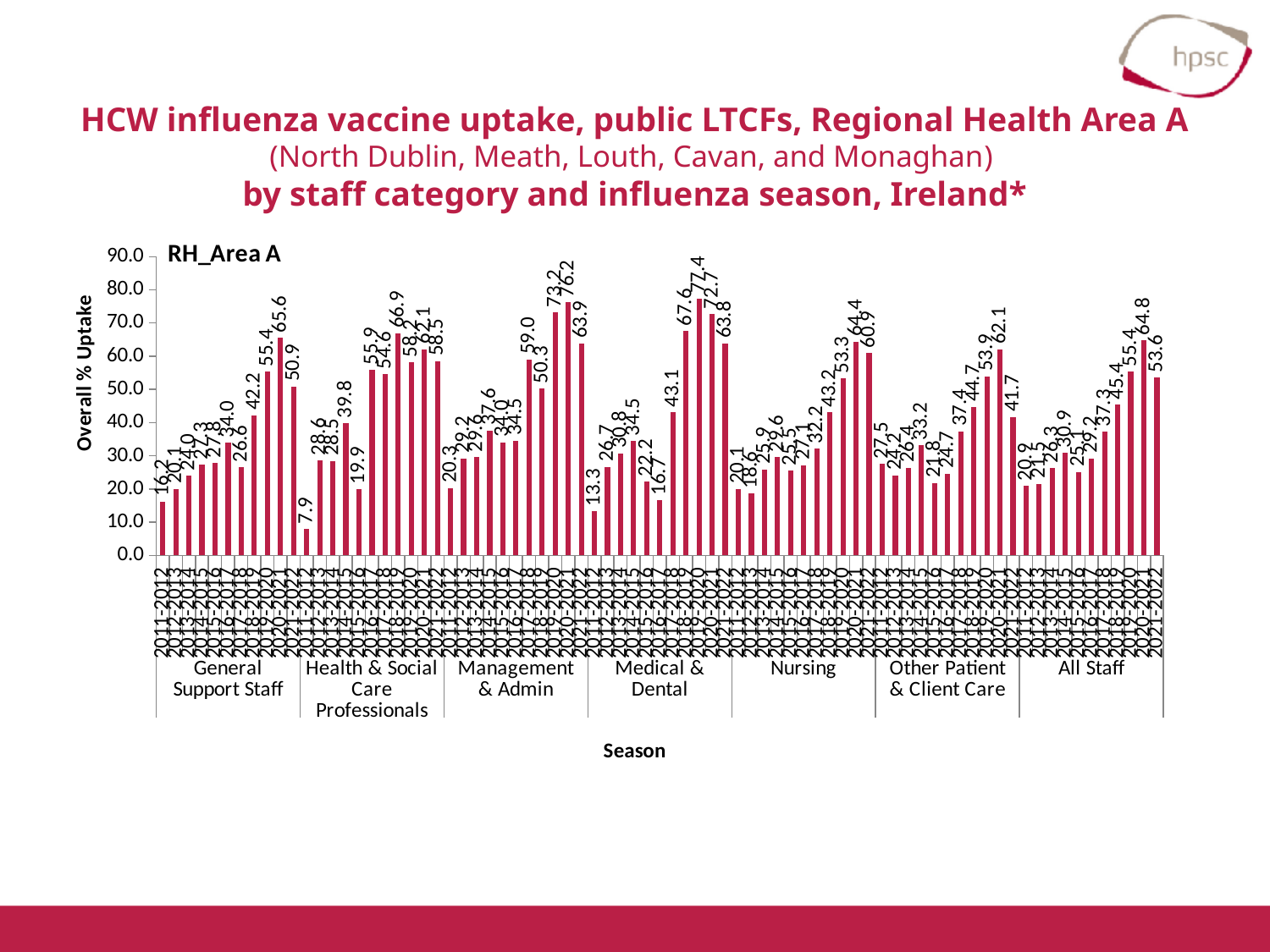
Which staff category group contains the lowest bar on the whole chart? Health & Social Care Professionals Which is larger: the highest value in the General Support Staff group or the highest value in the Other Patient & Client Care group? General Support Staff (65.6) What is the value of the first bar in the General Support Staff group? 16.2 What is the highest value shown in the Management & Admin group? 76.2 How many staff category groups are shown along the x axis of the chart? 7 What is the label on the y axis of the chart? Overall % Uptake What is the lowest value shown in the Health & Social Care Professionals group? 7.9 What is the highest value shown in the Medical & Dental group? 77.4 What is the highest value shown in the Nursing group? 64.4 What kind of chart is shown on the slide? Bar chart What is the value of the last bar in the All Staff group? 53.6 What is the difference between the highest value in the Medical & Dental group (77.4) and the highest value in the Nursing group (64.4)? 13.0